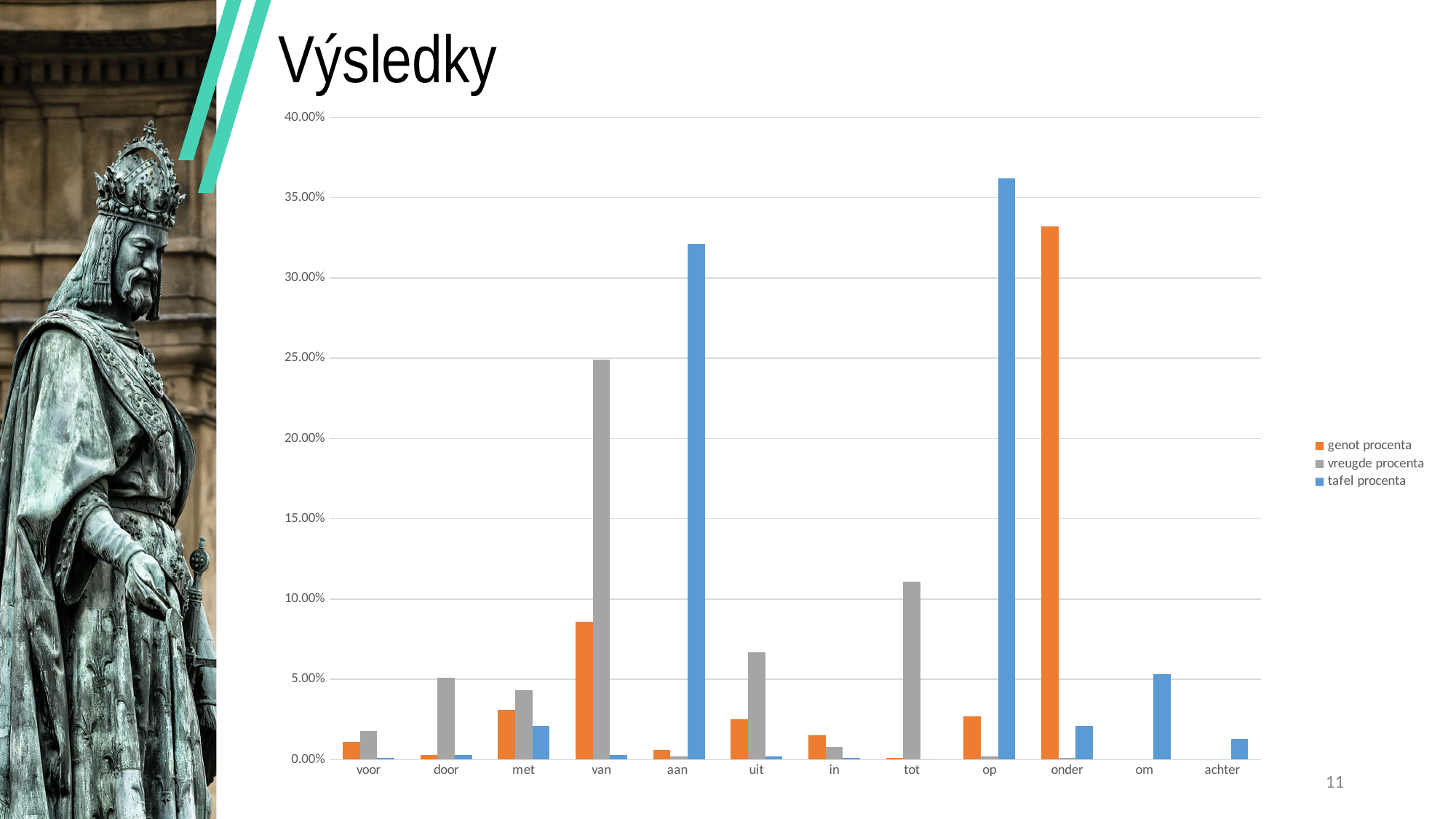
Which category has the highest value for the tafel procenta series? op Which category has the highest value for the vreugde procenta series? van Which is larger: the tafel procenta value for op or the genot procenta value for onder? tafel procenta for op How many categories are shown on the x axis? 12 Is the genot procenta value for van greater or less than 10.00%? less What is the title of the slide containing the chart? Výsledky Is the tafel procenta value for om greater or less than 10.00%? less Is the vreugde procenta value for tot greater or less than 10.00%? greater What kind of chart is shown on the slide? bar chart How many series does the legend list? 3 Which category has the highest value for the genot procenta series? onder